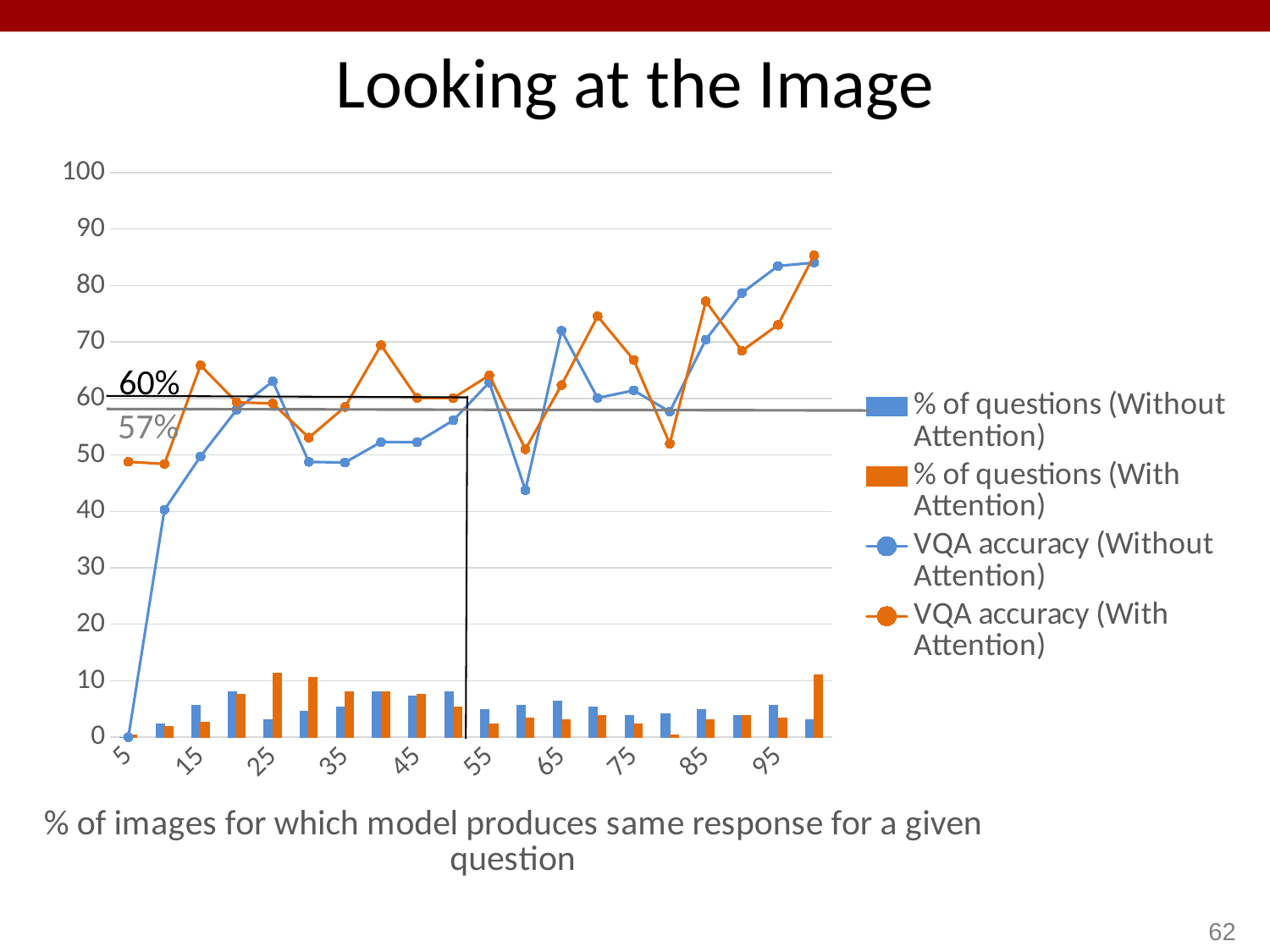
Is the VQA accuracy (Without Attention) value at x = 15 greater or less than 40? greater Does the VQA accuracy (Without Attention) line generally rise or fall as the x-axis value increases? rise How many series does the legend list? 4 Is the VQA accuracy (Without Attention) value at x = 5 greater or less than 10? less Is the VQA accuracy (Without Attention) value at x = 95 greater or less than 80? greater At x = 5, which is higher: VQA accuracy (With Attention) or VQA accuracy (Without Attention)? VQA accuracy (With Attention) At x = 25, which bar is taller: % of questions (With Attention) or % of questions (Without Attention)? % of questions (With Attention) What values do the two horizontal reference lines drawn across the chart mark? 60% and 57% What is the title of the slide containing the chart? Looking at the Image What kind of chart is shown on the slide? A combined bar and line chart